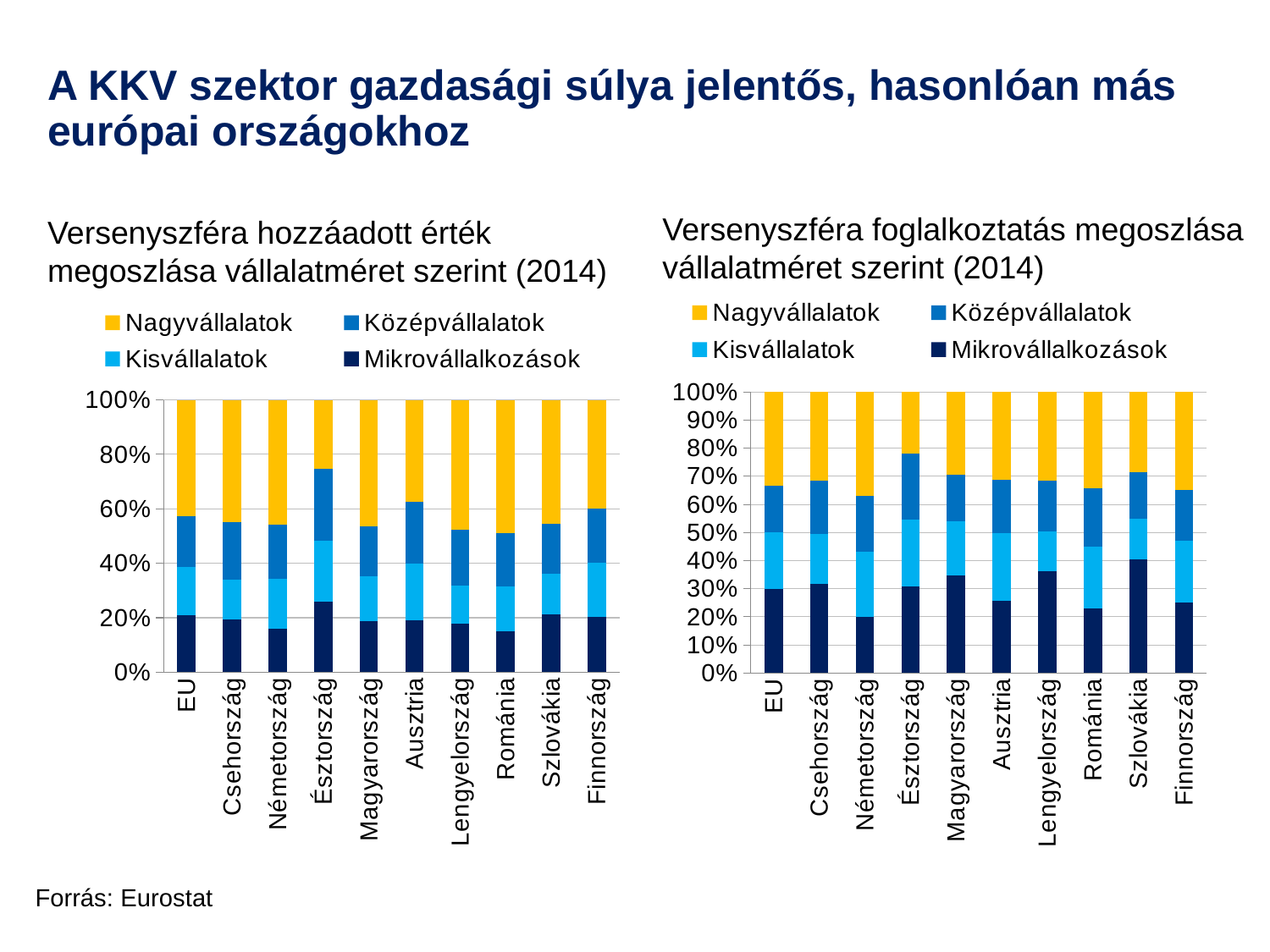
In the left chart (hozzáadott érték), which country has the largest Mikrovállalkozások share? Észtország In the left chart (hozzáadott érték), is the Mikrovállalkozások share for Románia greater or less than 20%? less How many series does the legend of the left chart list? 4 In the right chart (foglalkoztatás), which country has the smallest Mikrovállalkozások share? Németország Which series is shown in yellow in both charts? Nagyvállalatok In the right chart (foglalkoztatás), is the Mikrovállalkozások share for Németország greater or less than 30%? less In the left chart (hozzáadott érték), which country has the smallest Mikrovállalkozások share? Románia What kind of chart is the left chart, 'Versenyszféra hozzáadott érték megoszlása vállalatméret szerint (2014)'? Stacked bar chart How many countries/categories are shown on the x axis of the right chart, 'Versenyszféra foglalkoztatás megoszlása vállalatméret szerint (2014)'? 10 In the right chart (foglalkoztatás), which country has the largest Mikrovállalkozások share? Szlovákia In the right chart (foglalkoztatás), is the Mikrovállalkozások share for Szlovákia larger or smaller than that for Ausztria? larger In the left chart (hozzáadott érték), is the Mikrovállalkozások share for Észtország greater or less than 20%? greater